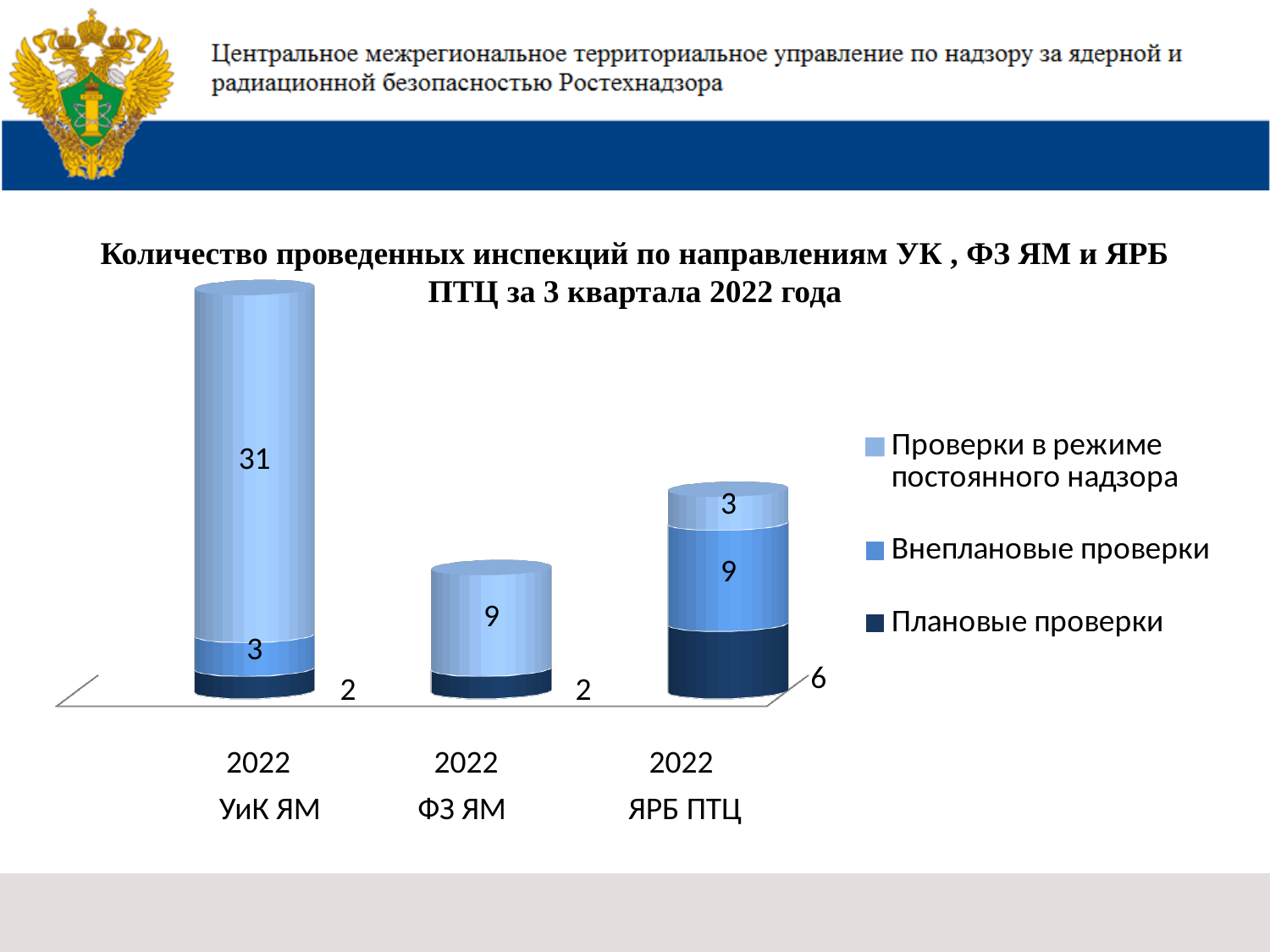
What type of chart is shown on the slide? bar chart What is the value of Проверки в режиме постоянного надзора for ФЗ ЯМ? 9 What is the value of Плановые проверки for ЯРБ ПТЦ? 6 Which is larger: Внеплановые проверки for УиК ЯМ or for ЯРБ ПТЦ? ЯРБ ПТЦ What is the value of Внеплановые проверки for ЯРБ ПТЦ? 9 How many series does the legend list? 3 What is the total of the stacked bar for ЯРБ ПТЦ? 18 Which category has the lowest value for Проверки в режиме постоянного надзора? ЯРБ ПТЦ What is the value of Проверки в режиме постоянного надзора for УиК ЯМ? 31 Which category has the highest value for Плановые проверки? ЯРБ ПТЦ How many categories (bars) are shown on the x axis? 3 What is the difference between Проверки в режиме постоянного надзора for УиК ЯМ and for ФЗ ЯМ? 22